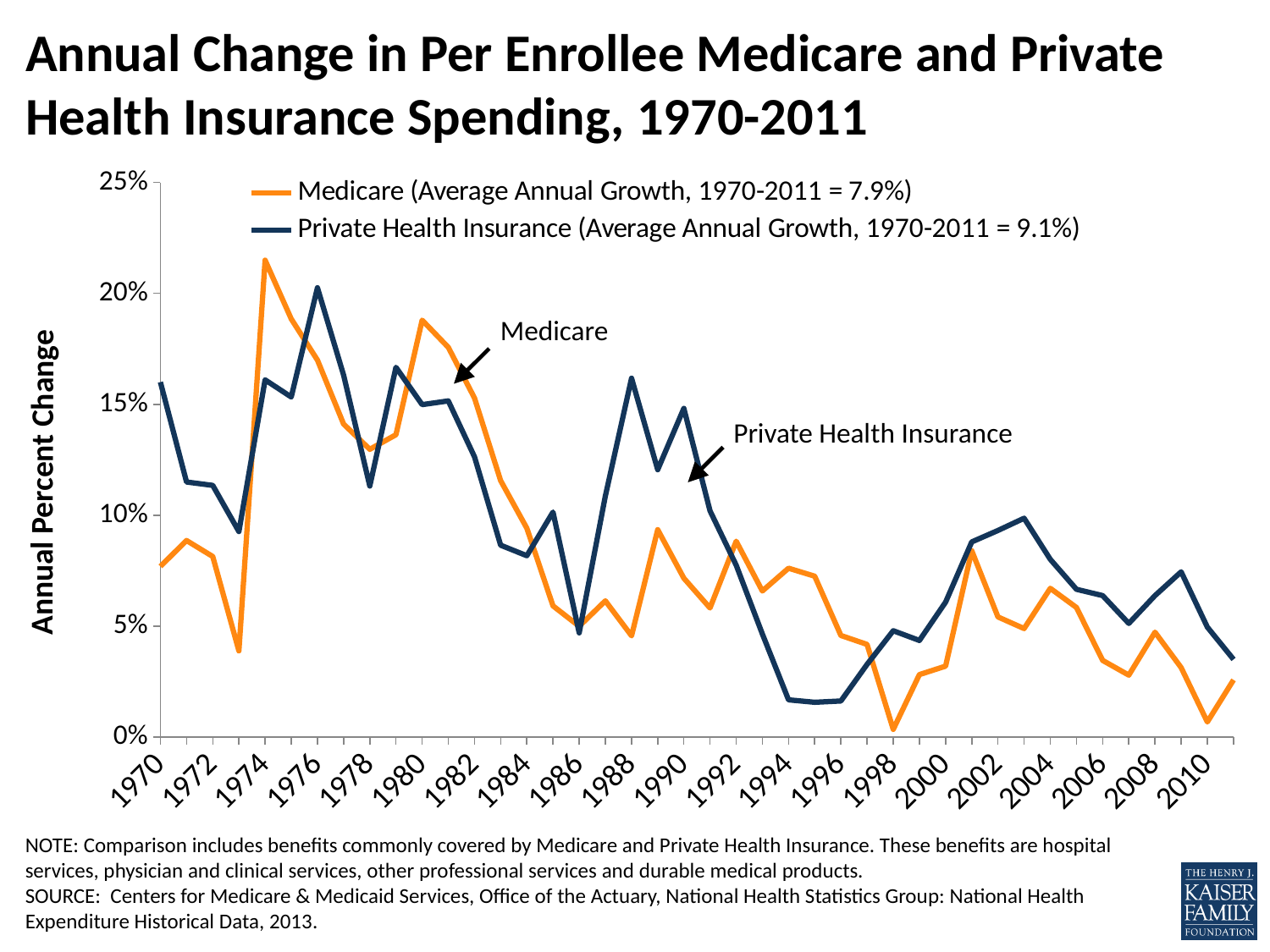
Which series had the higher average annual growth over 1970-2011, Medicare or Private Health Insurance? Private Health Insurance Is the Private Health Insurance value for 1988 greater or less than 15%? greater In 1998, which series has the larger value, Medicare or Private Health Insurance? Private Health Insurance Is the Medicare value for 1998 greater or less than 5%? less According to the legend, what was the average annual growth for Private Health Insurance over 1970-2011? 9.1% Overall, do the annual percent change values rise or fall from 1970 to 2011? Fall What kind of chart is shown on the slide? Line chart Is the Private Health Insurance value for 1994 greater or less than 5%? less According to the legend, what was the average annual growth for Medicare over 1970-2011? 7.9% How many series does the legend list? 2 What is the label on the vertical axis? Annual Percent Change